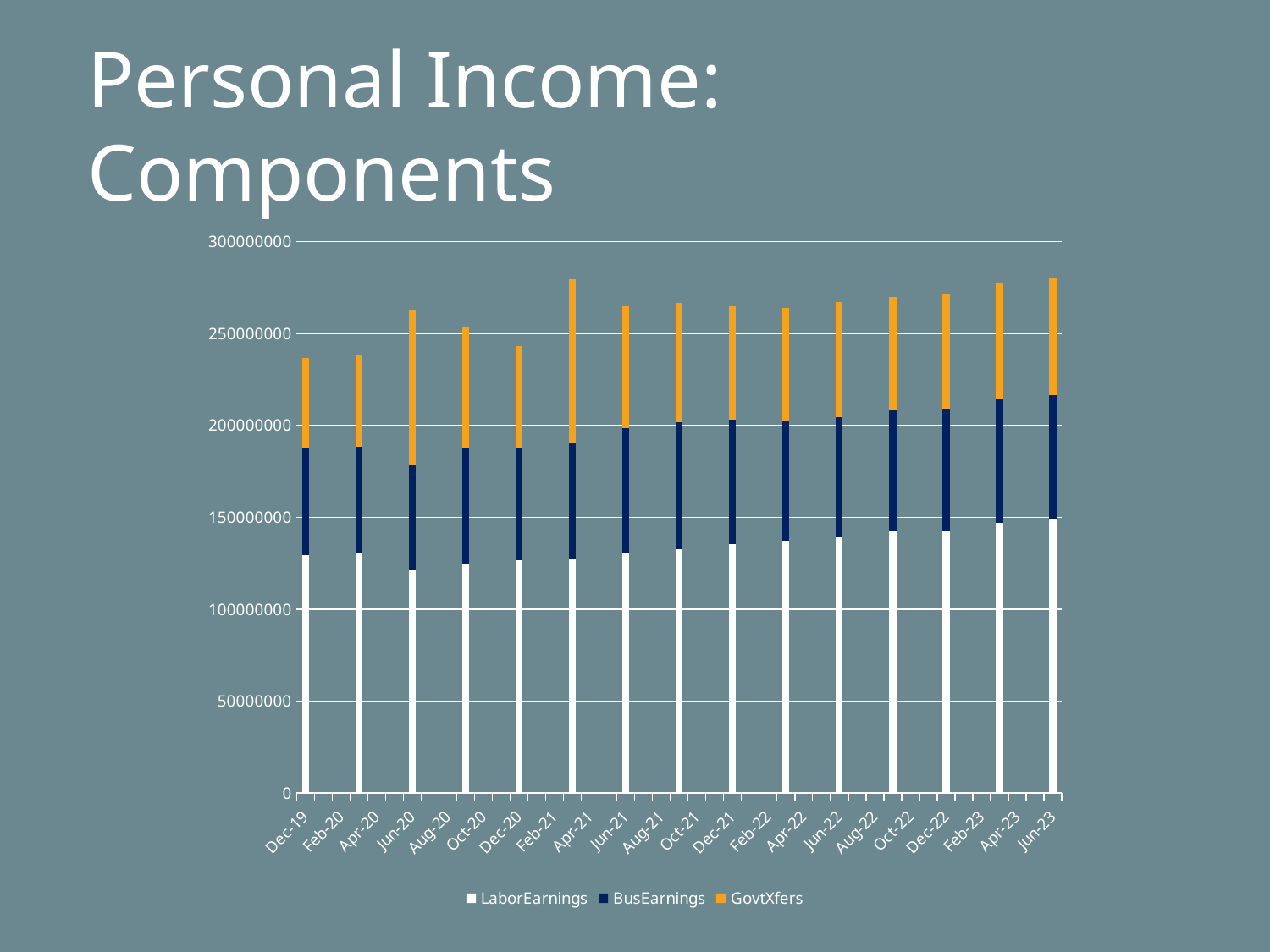
Is the total stacked value for Dec-19 greater or less than 250000000? less Which is larger, the total stacked value for Dec-19 or for Jun-23? Jun-23 How many stacked bars are plotted on the chart? 15 How many series does the legend list? 3 Is the total stacked value for Jun-23 greater or less than 300000000? less What are the three series named in the legend? LaborEarnings, BusEarnings, GovtXfers Is the LaborEarnings value for Dec-19 greater or less than 150000000? less Which series forms the largest segment of each stacked bar? LaborEarnings Do the total stacked values generally rise or fall from Dec-19 to Jun-23? Rise What is the title of the slide containing the chart? Personal Income: Components What kind of chart is shown on the slide? Stacked bar chart